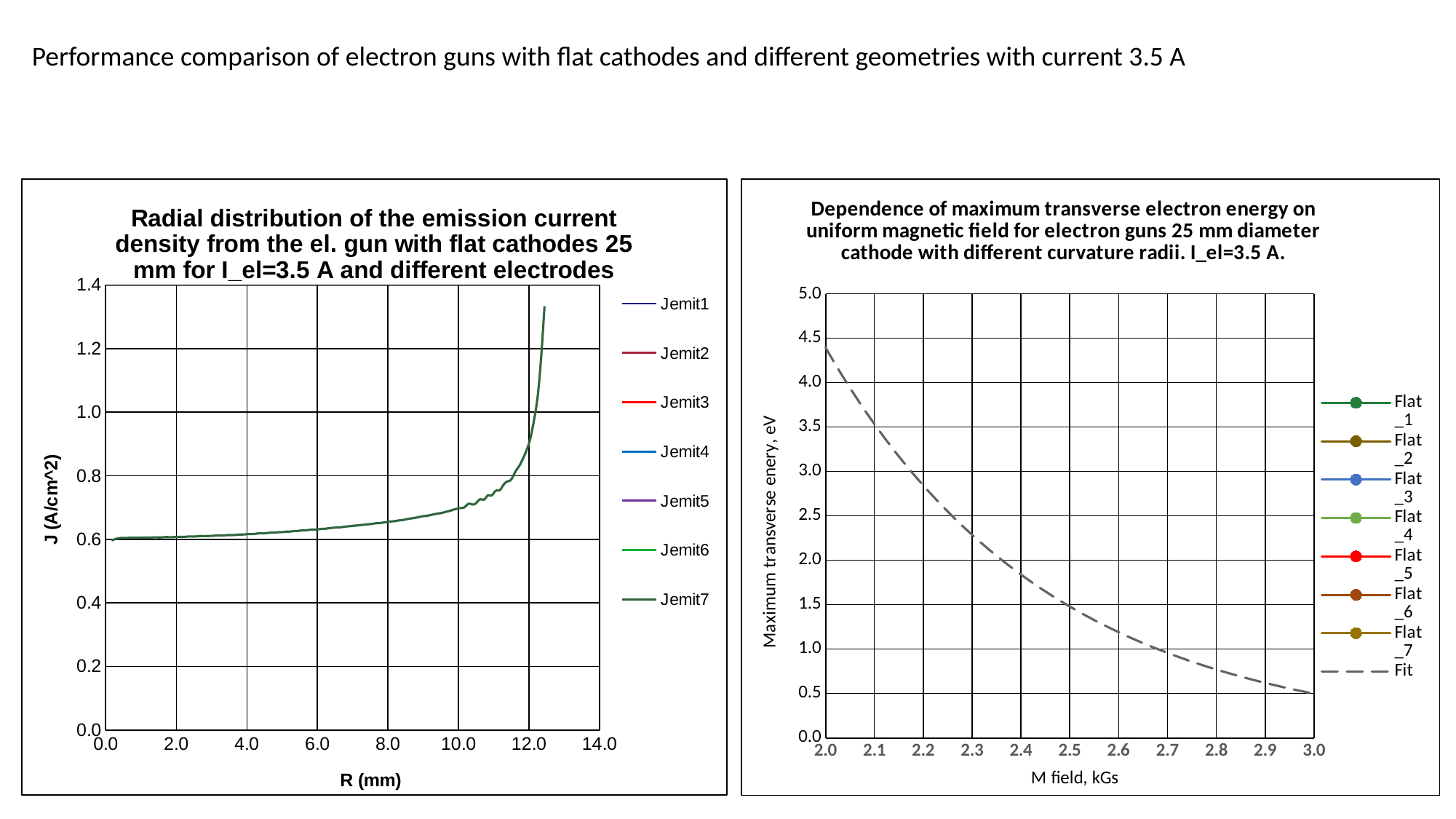
What type of chart is the left chart titled 'Radial distribution of the emission current density'? line chart What is the x-axis label of the left chart? R (mm) In the right chart, is the Fit value at M field = 3.0 kGs greater or less than 1.0 eV? less What type of chart is the right chart titled 'Dependence of maximum transverse electron energy on uniform magnetic field'? line chart In the right chart, does the maximum transverse energy rise or fall as the M field increases from 2.0 to 3.0 kGs? fall In the left chart, is the value of J at R = 2.0 mm greater or less than 0.8 A/cm^2? less In the left chart, is the value of J at R = 12.0 mm greater or less than 0.8 A/cm^2? greater What is the y-axis label of the right chart? Maximum transverse enery, eV In the left chart, does the emission current density J rise or fall as R increases? rise How many entries does the legend of the right chart list? 8 How many series does the legend of the left chart list? 7